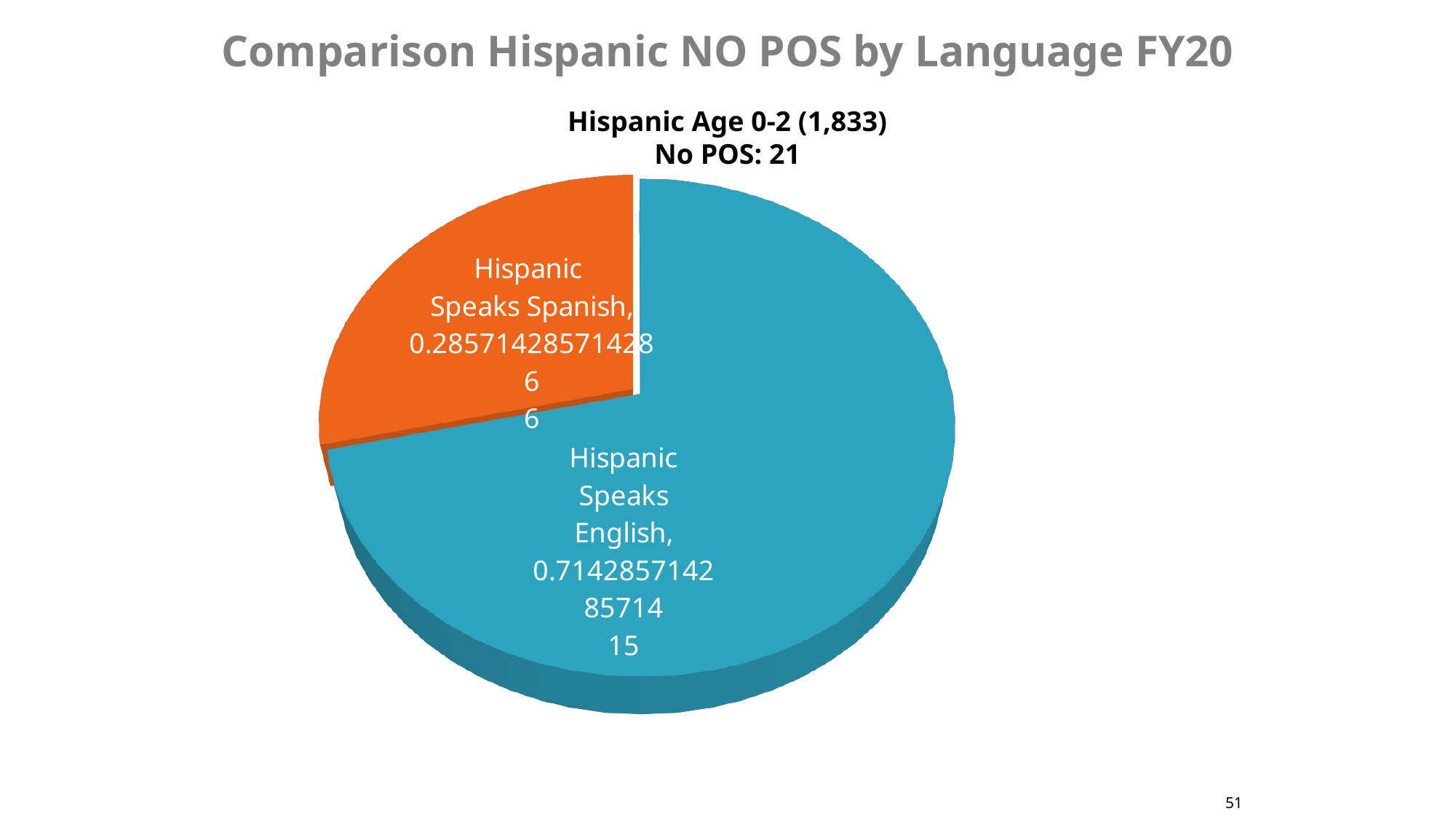
What is the count shown for Hispanic Speaks Spanish? 6 Which is larger, the count for Hispanic Speaks Spanish or for Hispanic Speaks English? Hispanic Speaks English What is the count shown for Hispanic Speaks English? 15 What is the chart's title? Hispanic Age 0-2 (1,833) No POS: 21 What colour is the Hispanic Speaks Spanish slice? Orange What is the difference between the counts for Hispanic Speaks English and Hispanic Speaks Spanish? 9 What share of the pie does Hispanic Speaks Spanish represent, as printed on the slide? 0.285714285714286 What share of the pie does Hispanic Speaks English represent, as printed on the slide? 0.714285714285714 What type of chart is shown on the slide? Pie chart Which slice is the largest in the pie chart? Hispanic Speaks English Which slice is the smallest in the pie chart? Hispanic Speaks Spanish How many slices does the pie chart have? 2